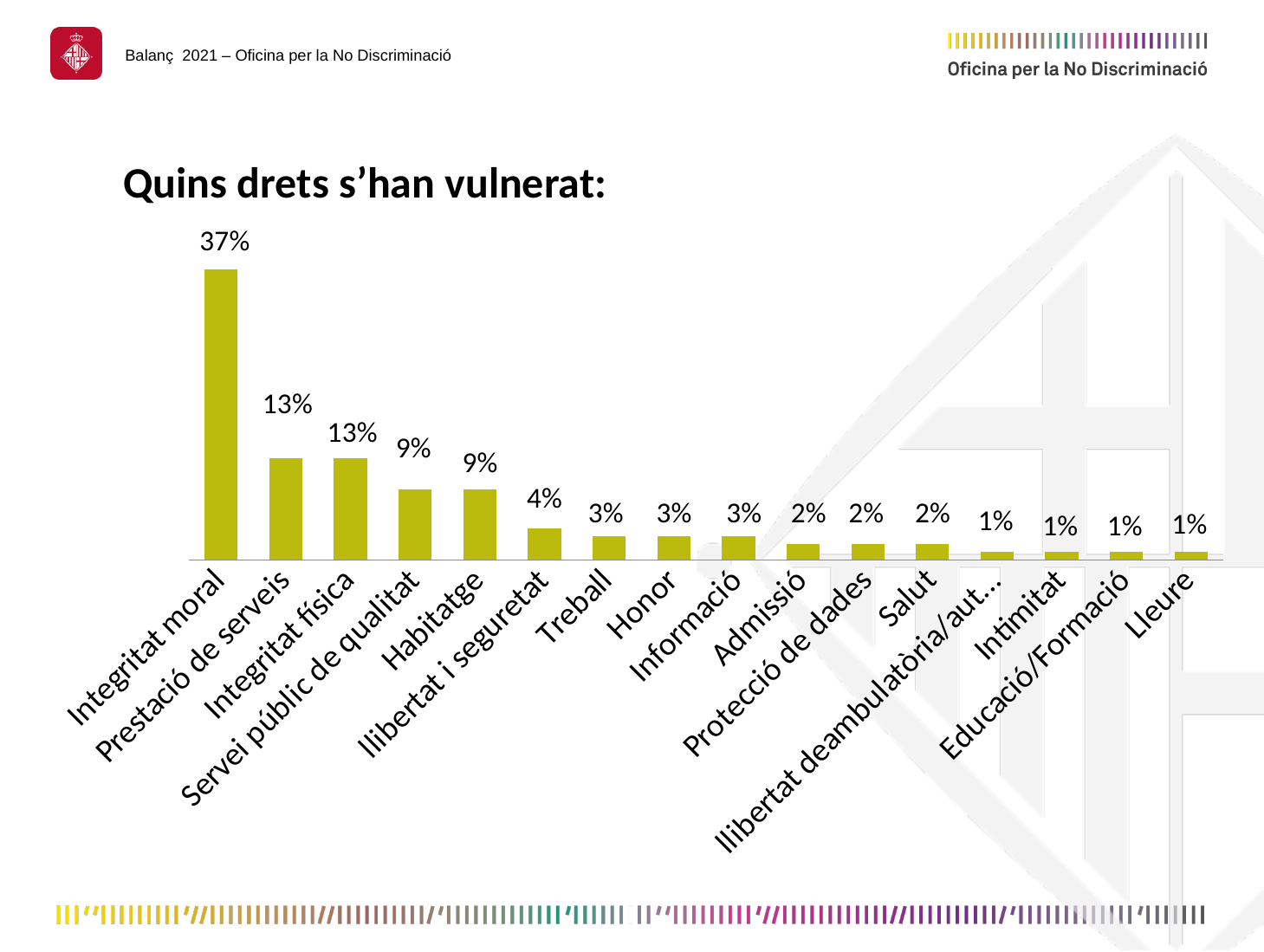
How many categories are shown in the chart? 16 Which is larger, the value for Integritat física or the value for Honor? Integritat física Which category has the highest value? Integritat moral What is the title of the chart? Quins drets s'han vulnerat: What is the value for Habitatge? 9% What is the value for Integritat moral? 37% What is the value for Lleure? 1% What is the value for Salut? 2% What is the difference between the values for Integritat moral and Prestació de serveis? 24% What is the value for Treball? 3% What is the difference between the values for Servei públic de qualitat and llibertat i seguretat? 5% What kind of chart is shown on the slide? Bar chart